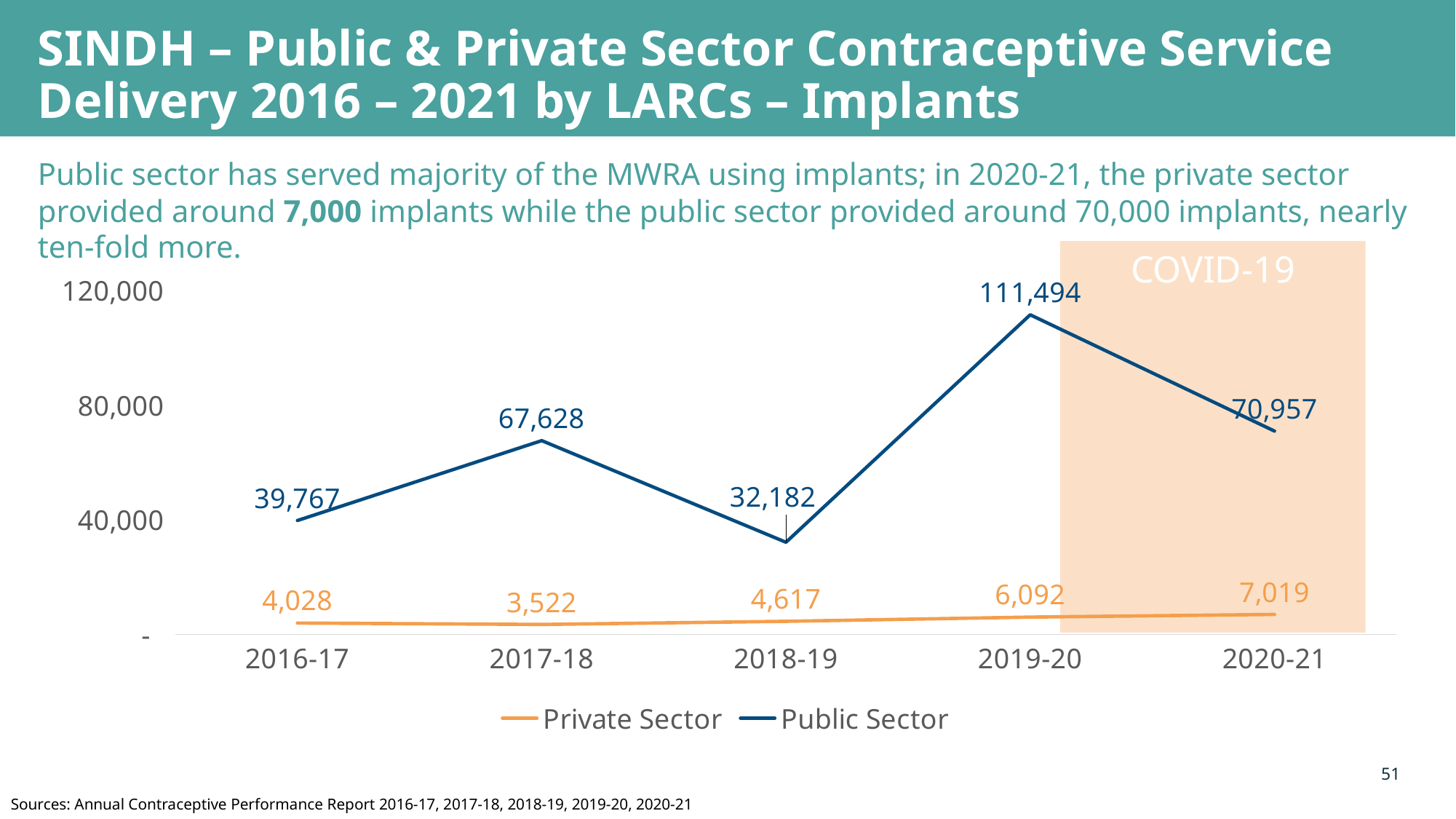
What kind of chart is shown on the slide? line chart How many series does the legend list? 2 What was the Public Sector value in 2019-20? 111,494 How many years are shown on the x axis? 5 What was the Public Sector value in 2020-21? 70,957 In which year was the Public Sector value highest? 2019-20 Did the Private Sector value rise or fall from 2017-18 to 2020-21? rise In which year was the Private Sector value lowest? 2017-18 What is the difference between the Public Sector values in 2019-20 and 2020-21? 40,537 Is the Public Sector value for 2017-18 greater or less than 80,000? less Which was larger, the Public Sector value in 2016-17 or in 2018-19? 2016-17 What was the Private Sector value in 2017-18? 3,522